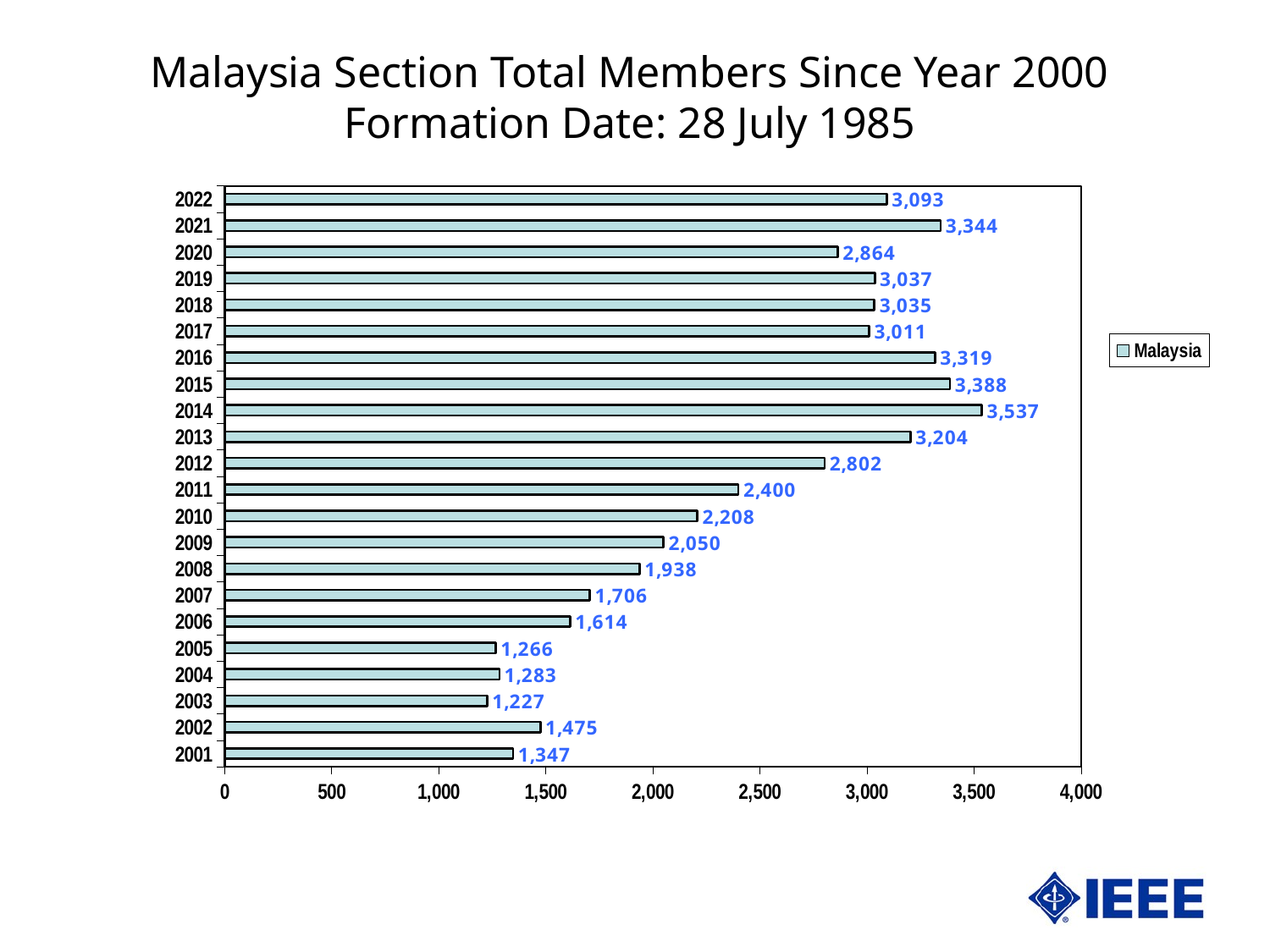
What is the value for 2014? 3,537 Is the value for 2011 greater or less than 2,500? less Which is larger, the value for 2012 or the value for 2020? 2020 What is the value for 2001? 1,347 How many years are shown on the chart? 22 What kind of chart is shown on the slide? bar chart Which year has the highest value? 2014 What is the value for 2022? 3,093 How many series does the legend list? 1 Which year has the lowest value? 2003 What is the difference between the values for 2021 and 2022? 251 What series name is shown in the legend? Malaysia